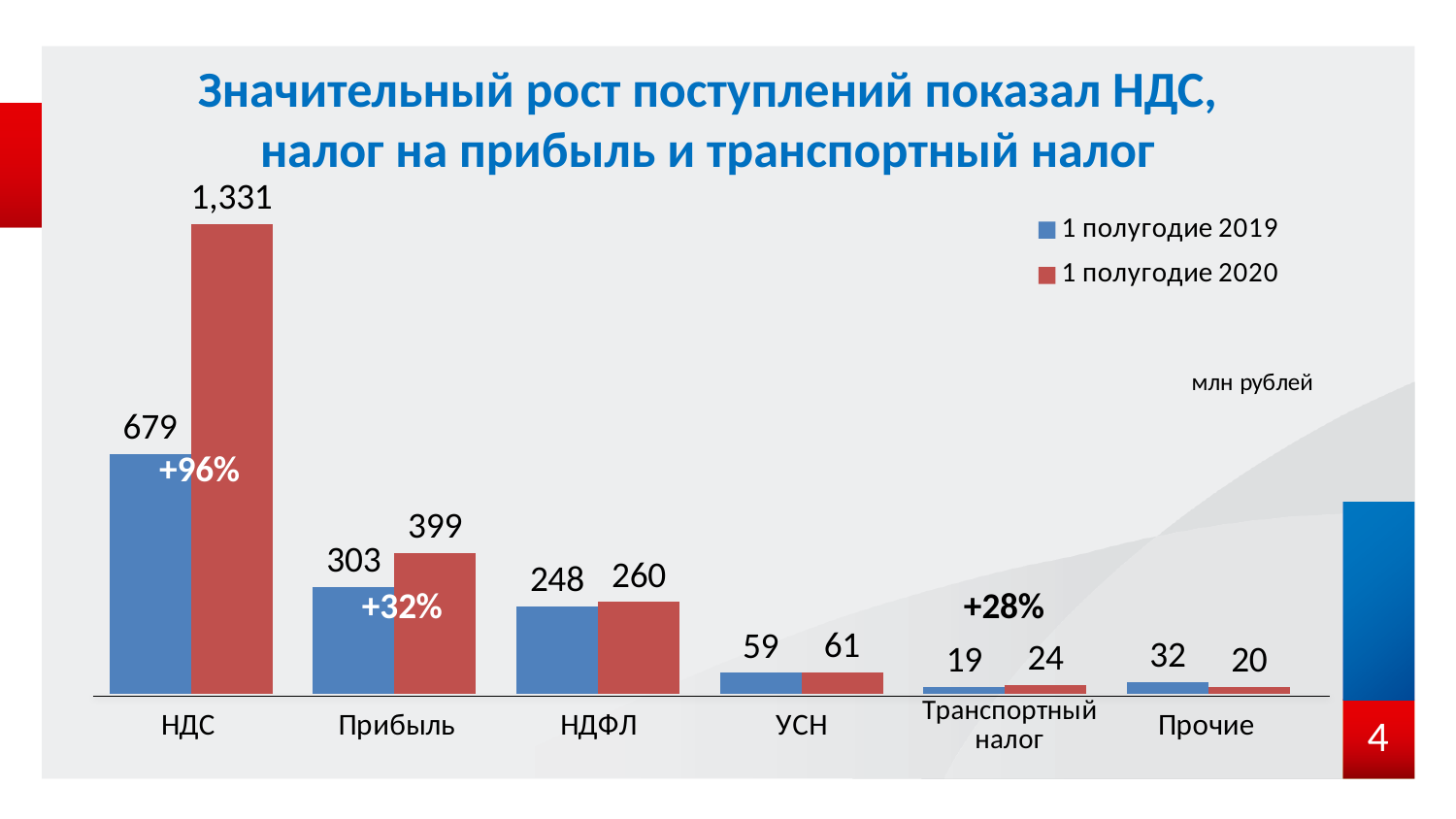
What is the value for Транспортный налог in 1 полугодие 2020? 24 How many categories are shown on the x axis? 6 How many series does the legend list? 2 What is the difference between the 1 полугодие 2020 and 1 полугодие 2019 values for НДФЛ? 12 Which is larger for Прочие: the 1 полугодие 2019 value or the 1 полугодие 2020 value? 1 полугодие 2019 What is the difference between the 1 полугодие 2020 and 1 полугодие 2019 values for НДС? 652 What is the value for Прибыль in 1 полугодие 2019? 303 What is the value for НДС in 1 полугодие 2020? 1,331 Which category has the highest value in 1 полугодие 2020? НДС What unit is indicated for the values on the chart? млн рублей Which category has the lowest value in 1 полугодие 2019? Транспортный налог What kind of chart is shown on the slide? bar chart